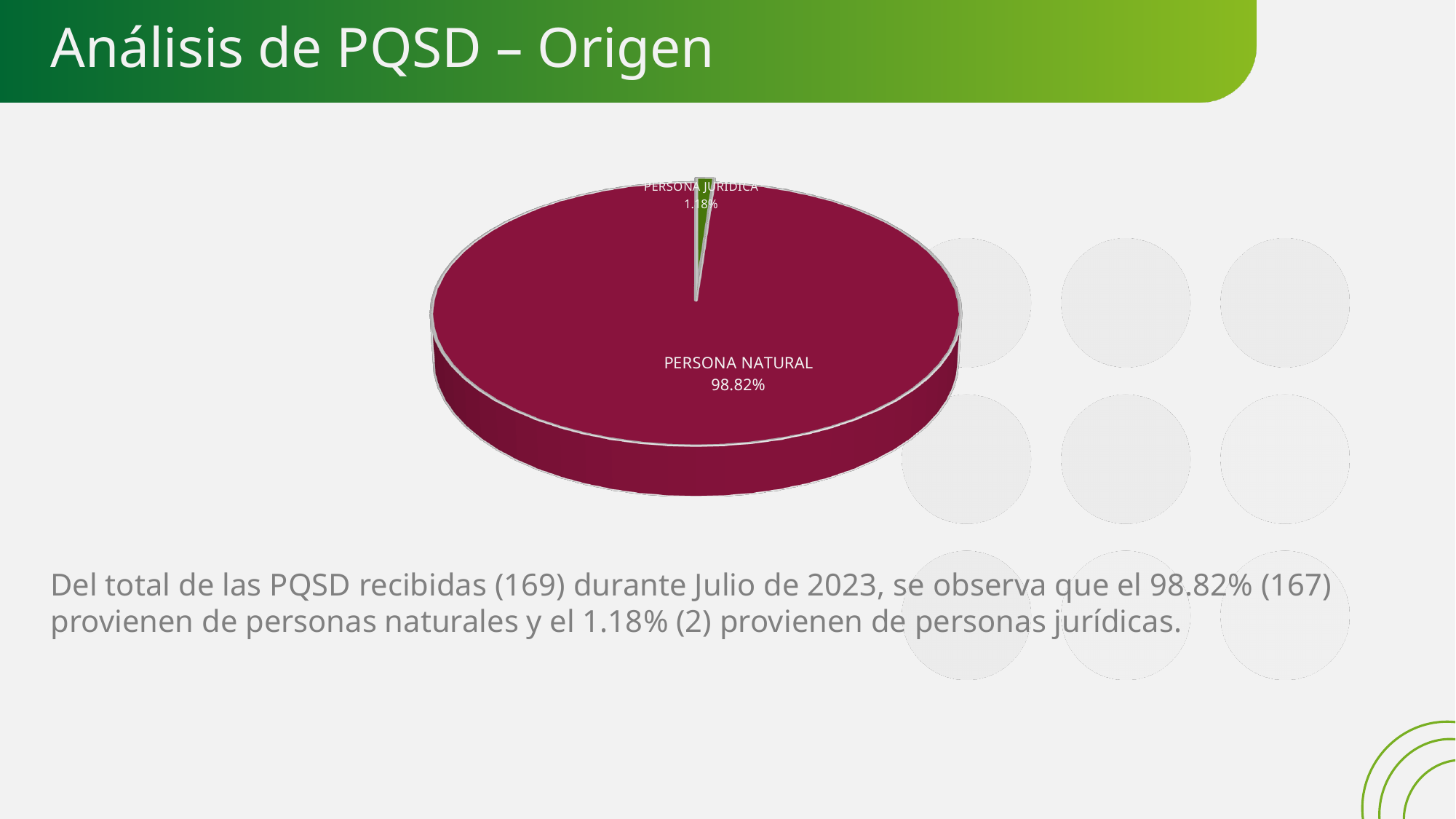
What share of the pie does PERSONA JURÍDICA represent? 1.18% What colour is the PERSONA NATURAL slice? Magenta/dark red What kind of chart is shown on the slide? Pie chart What colour is the PERSONA JURÍDICA slice? Green How many slices does the pie chart have? 2 Which category has the largest slice of the pie? PERSONA NATURAL What is the difference in percentage points between the PERSONA NATURAL and PERSONA JURÍDICA slices? 97.64% What share of the pie does PERSONA NATURAL represent? 98.82% Which category has the smallest slice of the pie? PERSONA JURÍDICA Which slice is larger, PERSONA NATURAL or PERSONA JURÍDICA? PERSONA NATURAL